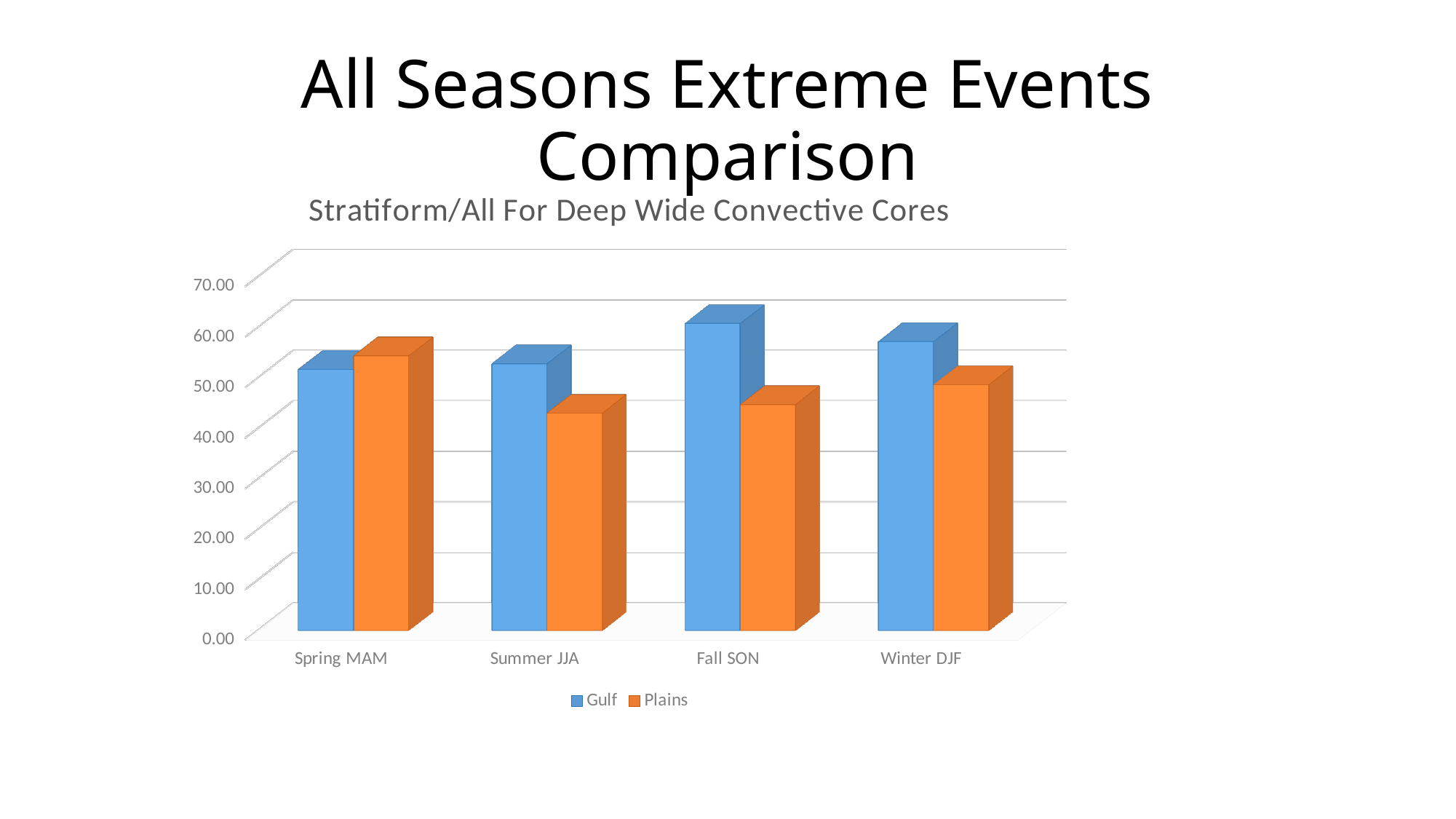
Is the Gulf value for Fall SON greater or less than 50.00? greater Which colour represents the Plains series? orange In Spring MAM, which series has the larger value, Gulf or Plains? Plains For which season is the Gulf value highest? Fall SON Is the Plains value for Winter DJF greater or less than 60.00? less What kind of chart is shown on the slide? bar chart In Summer JJA, which series has the larger value, Gulf or Plains? Gulf For which season is the Plains value highest? Spring MAM How many series does the legend list? 2 What is the title of the chart? Stratiform/All For Deep Wide Convective Cores Is the Plains value for Summer JJA greater or less than 50.00? less How many seasons (categories) are shown on the x axis? 4